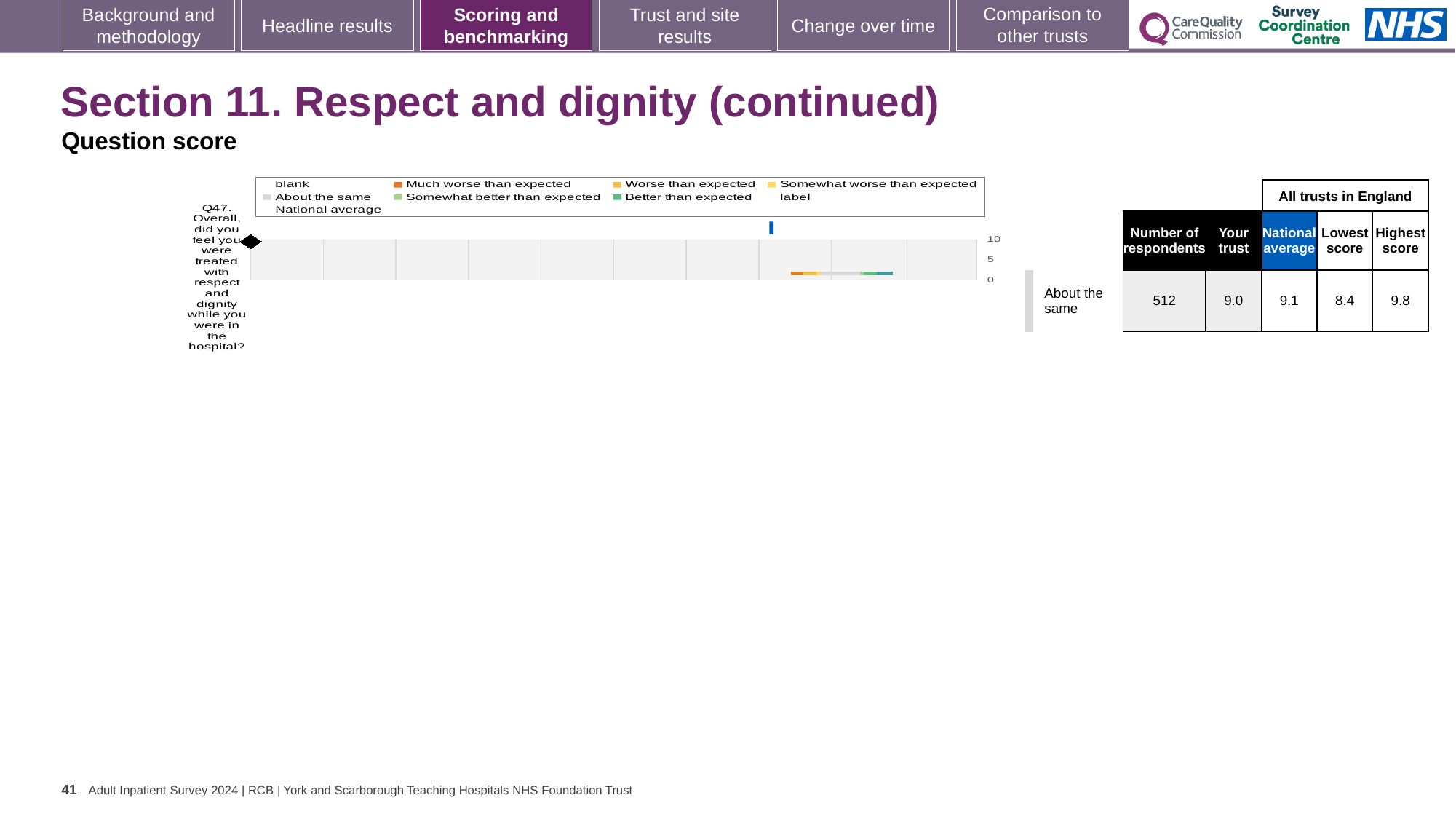
According to the table beside the chart, which is larger for Q47: the trust's score or the national average? national average According to the table beside the chart, what is the national average score for Q47? 9.1 How many questions (categories) are plotted on the chart? 1 How many entries does the chart legend list? 9 What is the highest value shown on the chart's axis? 10 Is the plotted score for Q47 greater or less than 5? greater What benchmarking category is the trust's Q47 score assigned to? About the same Which question number is plotted on the chart? Q47 According to the table beside the chart, what is the 'Your trust' score for Q47? 9.0 According to the table beside the chart, what is the difference between the highest score and the lowest score for Q47? 1.4 What kind of chart is shown on the slide? bar chart According to the table beside the chart, how many respondents answered Q47? 512